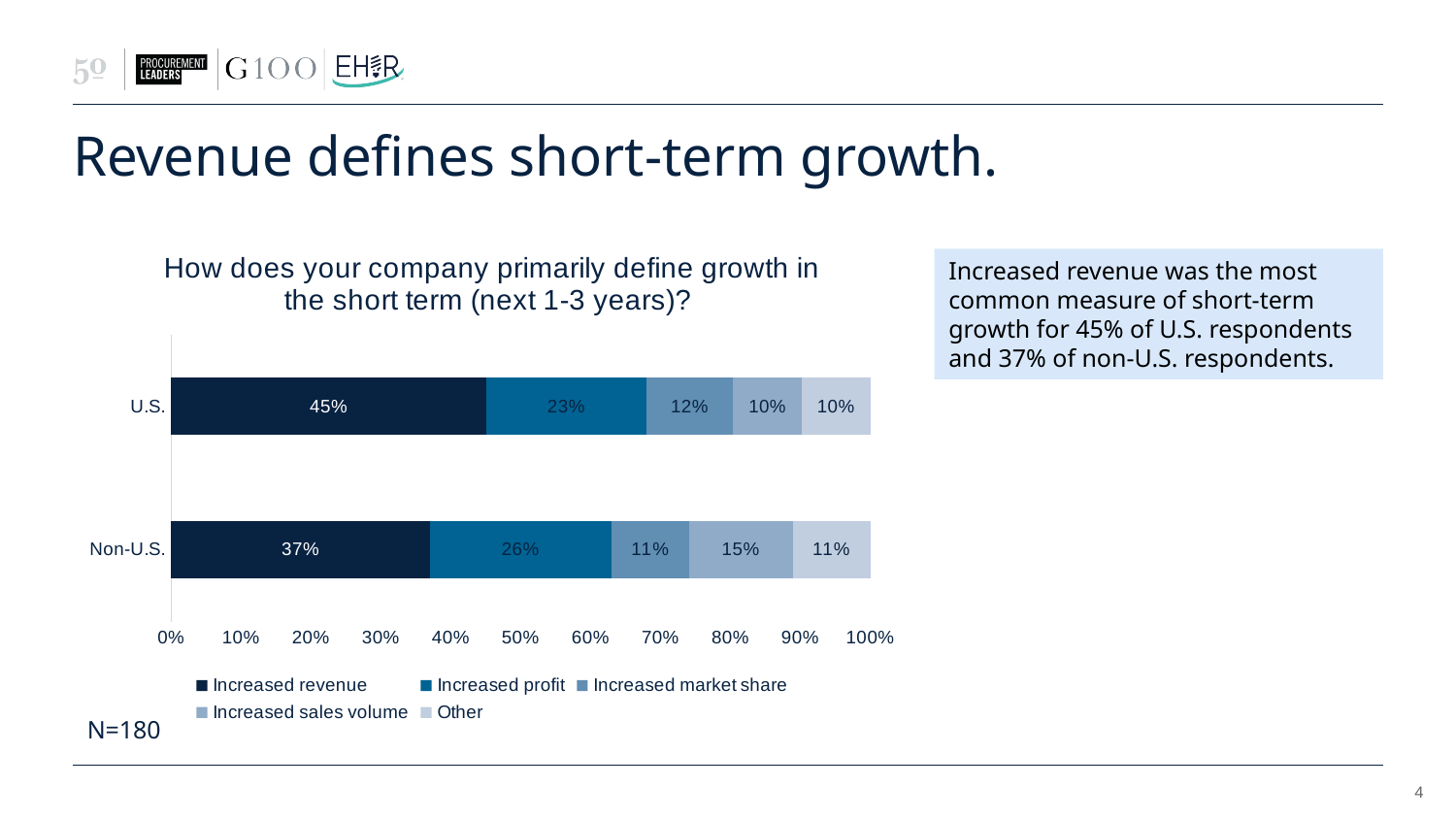
Which category has the highest share for U.S. respondents? Increased revenue What is the total of the stacked bar for non-U.S. respondents? 100% What percentage of U.S. respondents define short-term growth as increased revenue? 45% Which group has a larger share for increased sales volume, U.S. or non-U.S.? Non-U.S. How many categories are shown on the vertical axis? 2 What is the difference between the U.S. and non-U.S. values for increased revenue? 8 percentage points What is the value for increased market share among U.S. respondents? 12% How many series does the legend list? 5 What percentage of non-U.S. respondents define short-term growth as increased profit? 26% What kind of chart is shown on the slide? Stacked bar chart What is the sample size (N) shown on the slide? N=180 What is the value for increased sales volume among non-U.S. respondents? 15%